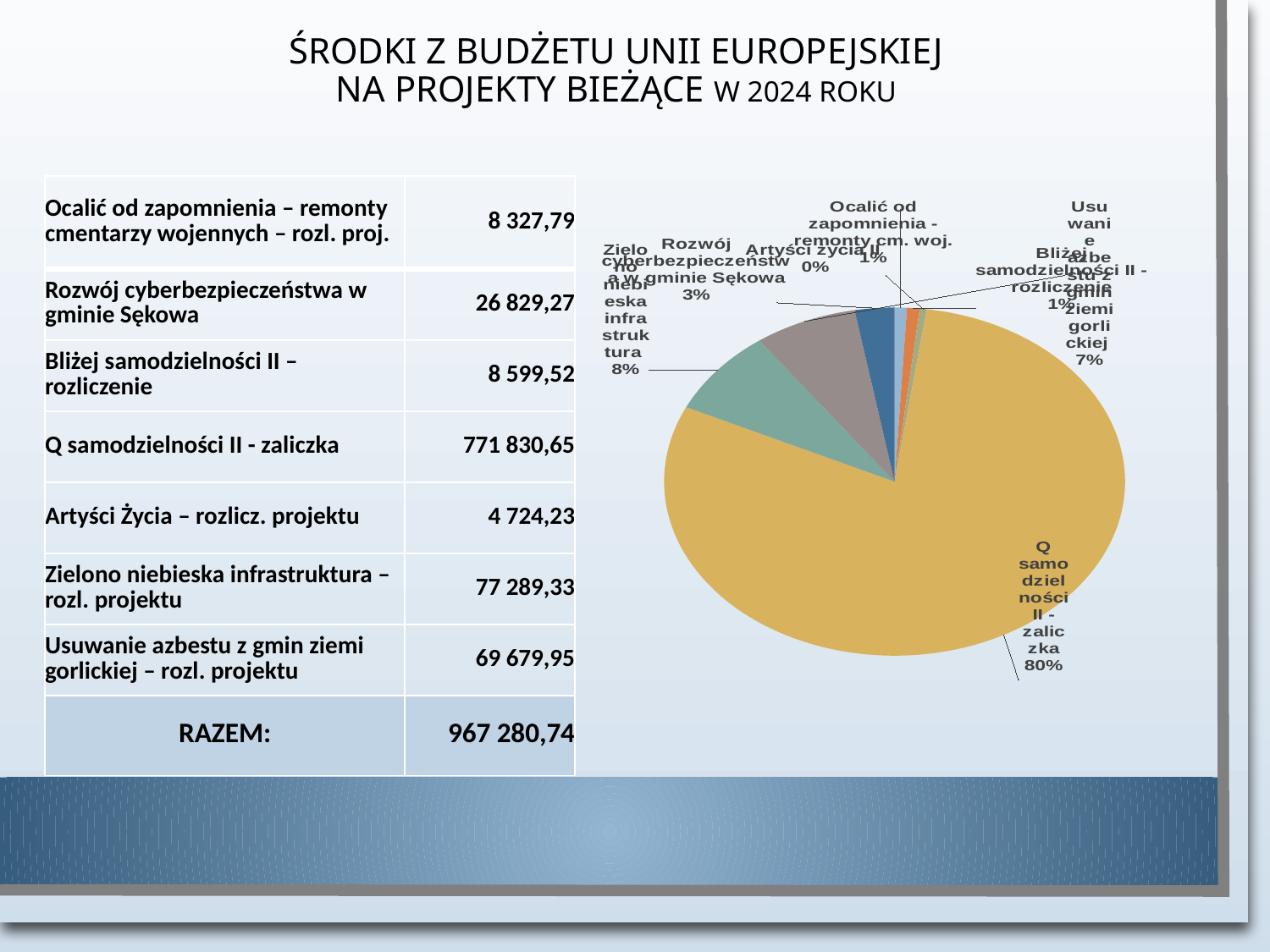
Which slice is larger: "Zielono niebieska infrastruktura" or "Rozwój cyberbezpieczeństwa w gminie Sękowa"? Zielono niebieska infrastruktura What share of the pie does "Q samodzielności II - zaliczka" represent? 80% What share of the pie does "Usuwanie azbestu z gmin ziemi gorlickiej" represent? 7% What kind of chart is shown on the slide? pie chart Which slice of the pie chart is the largest? Q samodzielności II - zaliczka What percentage is shown for "Ocalić od zapomnienia - remonty cm. woj." in the pie chart? 1% Which slice of the pie chart is the smallest? Artyści życia What percentage is shown for "Artyści życia" in the pie chart? 0% What share of the pie does "Rozwój cyberbezpieczeństwa w gminie Sękowa" represent? 3% How many slices does the pie chart have? 7 What is the difference in percentage points between the "Q samodzielności II - zaliczka" slice and the "Zielono niebieska infrastruktura" slice? 72 percentage points